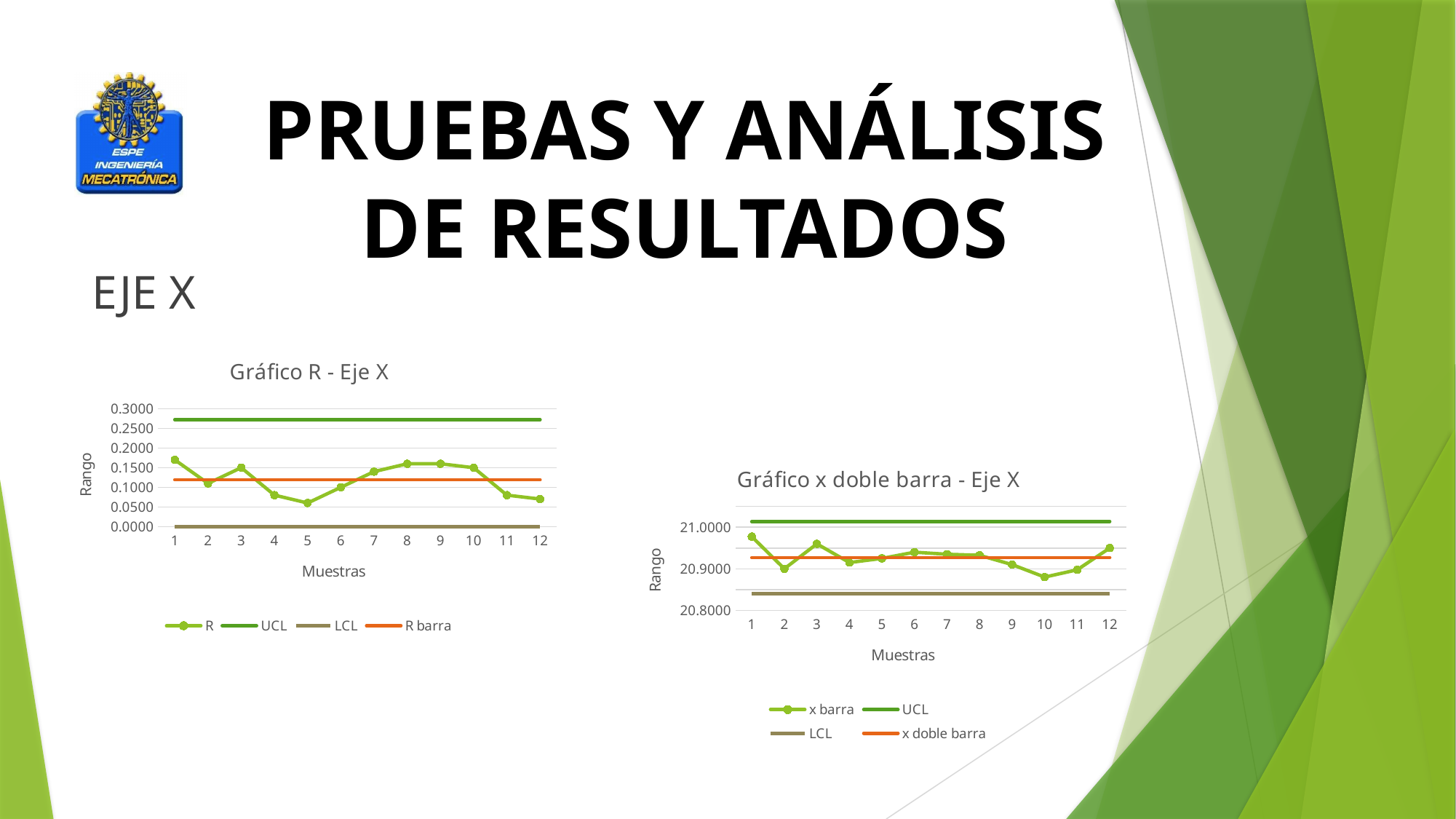
What kind of chart is "Gráfico R - Eje X"? line chart In "Gráfico x doble barra - Eje X", is the UCL line greater or less than 21.0000? greater How many series does the legend of "Gráfico x doble barra - Eje X" list? 4 In "Gráfico x doble barra - Eje X", at which sample is the x barra value lowest? 10 In "Gráfico R - Eje X", which is larger, the R value at sample 1 or at sample 5? sample 1 In "Gráfico R - Eje X", what is the value of the LCL line? 0.0000 In "Gráfico R - Eje X", is the R value at sample 1 greater or less than 0.1500? greater How many samples (Muestras) are plotted along the x axis of "Gráfico R - Eje X"? 12 In "Gráfico R - Eje X", do the R values rise or fall from sample 9 to sample 12? fall In "Gráfico R - Eje X", is the R value at sample 5 greater or less than 0.1000? less What is the x-axis title of "Gráfico x doble barra - Eje X"? Muestras